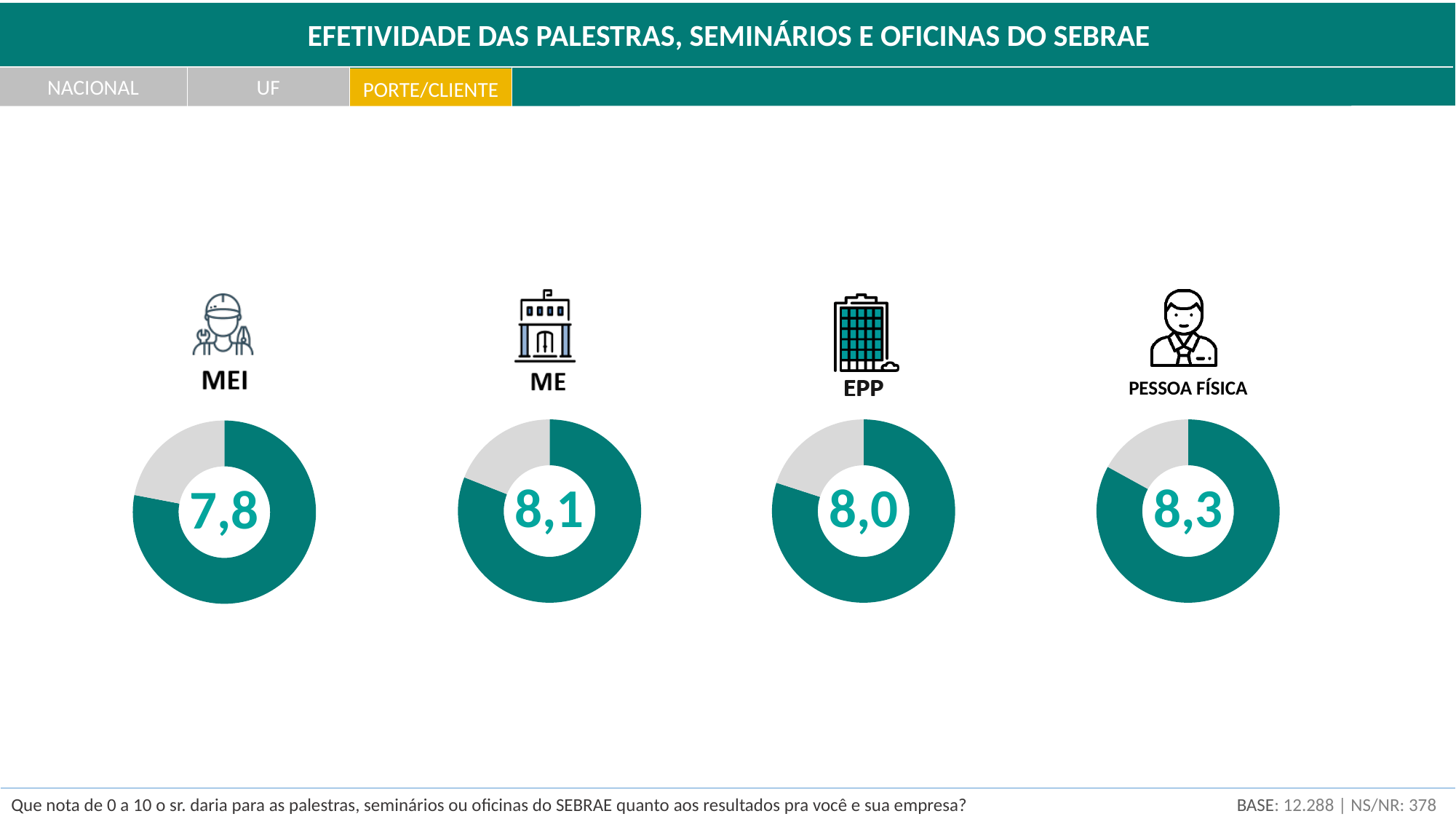
What is the title of the slide containing the donut charts? EFETIVIDADE DAS PALESTRAS, SEMINÁRIOS E OFICINAS DO SEBRAE What score is shown in the ME donut chart? 8,1 Which client group has the lowest score among the donut charts? MEI What is the difference between the PESSOA FÍSICA score and the MEI score? 0,5 What score is shown in the EPP donut chart? 8,0 Which client group has the highest score among the donut charts? PESSOA FÍSICA What kind of chart is used to display each client group's score? Donut chart Which has a higher score, ME or MEI? ME What score is shown in the MEI donut chart? 7,8 How many donut charts are shown on the slide? 4 What score is shown in the PESSOA FÍSICA donut chart? 8,3 What is the difference between the ME score and the EPP score? 0,1